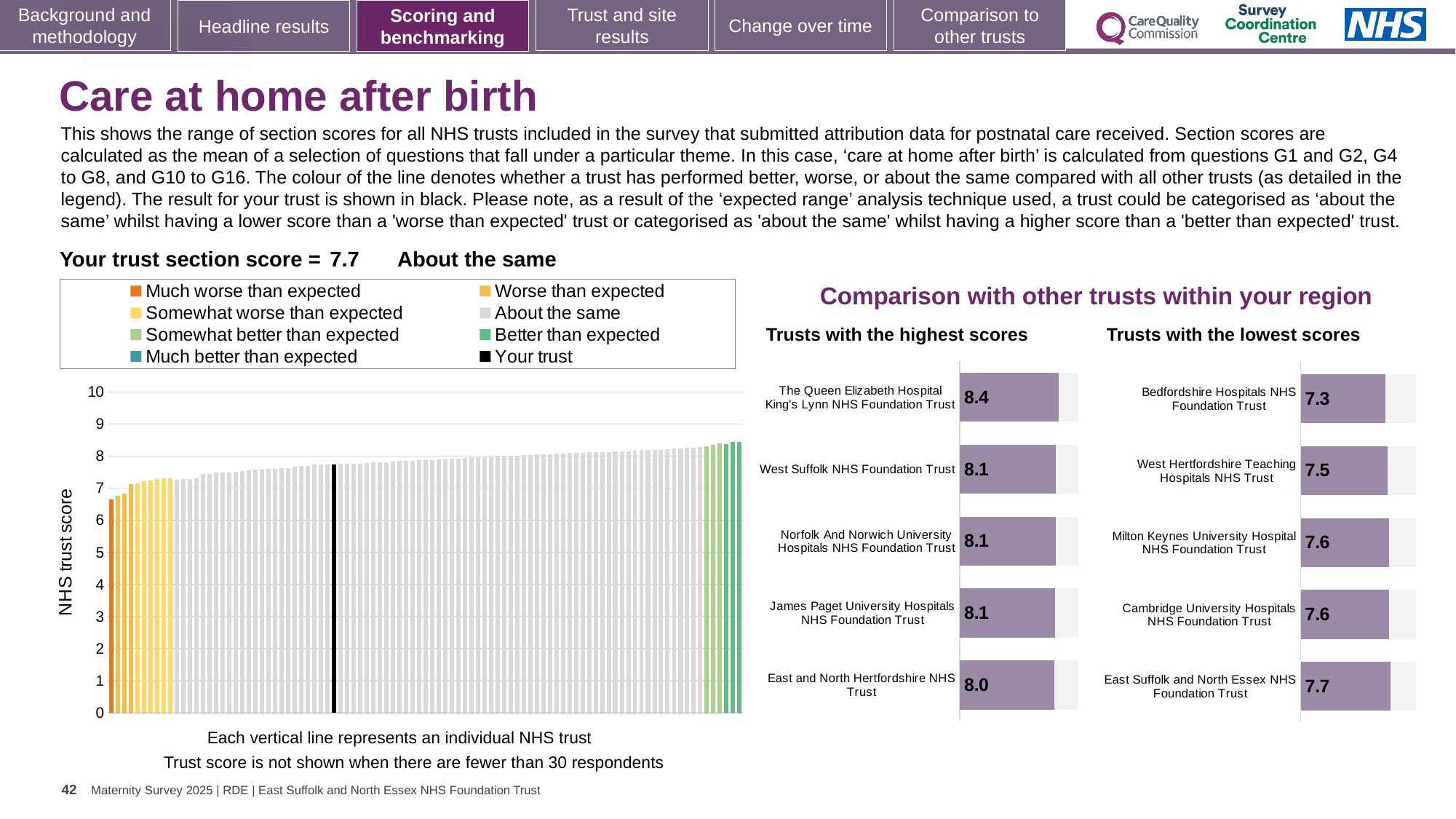
In the 'Trusts with the lowest scores' chart, which trust has the lowest score? Bedfordshire Hospitals NHS Foundation Trust In the 'Trusts with the highest scores' chart, what is the difference between the scores of The Queen Elizabeth Hospital King's Lynn NHS Foundation Trust and East and North Hertfordshire NHS Trust? 0.4 How many trusts are shown in the 'Trusts with the highest scores' chart? 5 In the 'Trusts with the highest scores' chart, what is the score for The Queen Elizabeth Hospital King's Lynn NHS Foundation Trust? 8.4 What kind of chart is the large chart on the left showing NHS trust scores? Bar chart In the 'Trusts with the lowest scores' chart, which has the higher score: West Hertfordshire Teaching Hospitals NHS Trust or Milton Keynes University Hospital NHS Foundation Trust? Milton Keynes University Hospital NHS Foundation Trust How many entries does the legend above the large chart on the left list? 8 In the 'Trusts with the highest scores' chart, which trust has the highest score? The Queen Elizabeth Hospital King's Lynn NHS Foundation Trust In the large chart on the left, do the trust scores rise or fall from left to right? Rise In the 'Trusts with the lowest scores' chart, what is the score for Bedfordshire Hospitals NHS Foundation Trust? 7.3 What is the label on the vertical axis of the large chart on the left? NHS trust score In the 'Trusts with the lowest scores' chart, what is the score for Cambridge University Hospitals NHS Foundation Trust? 7.6